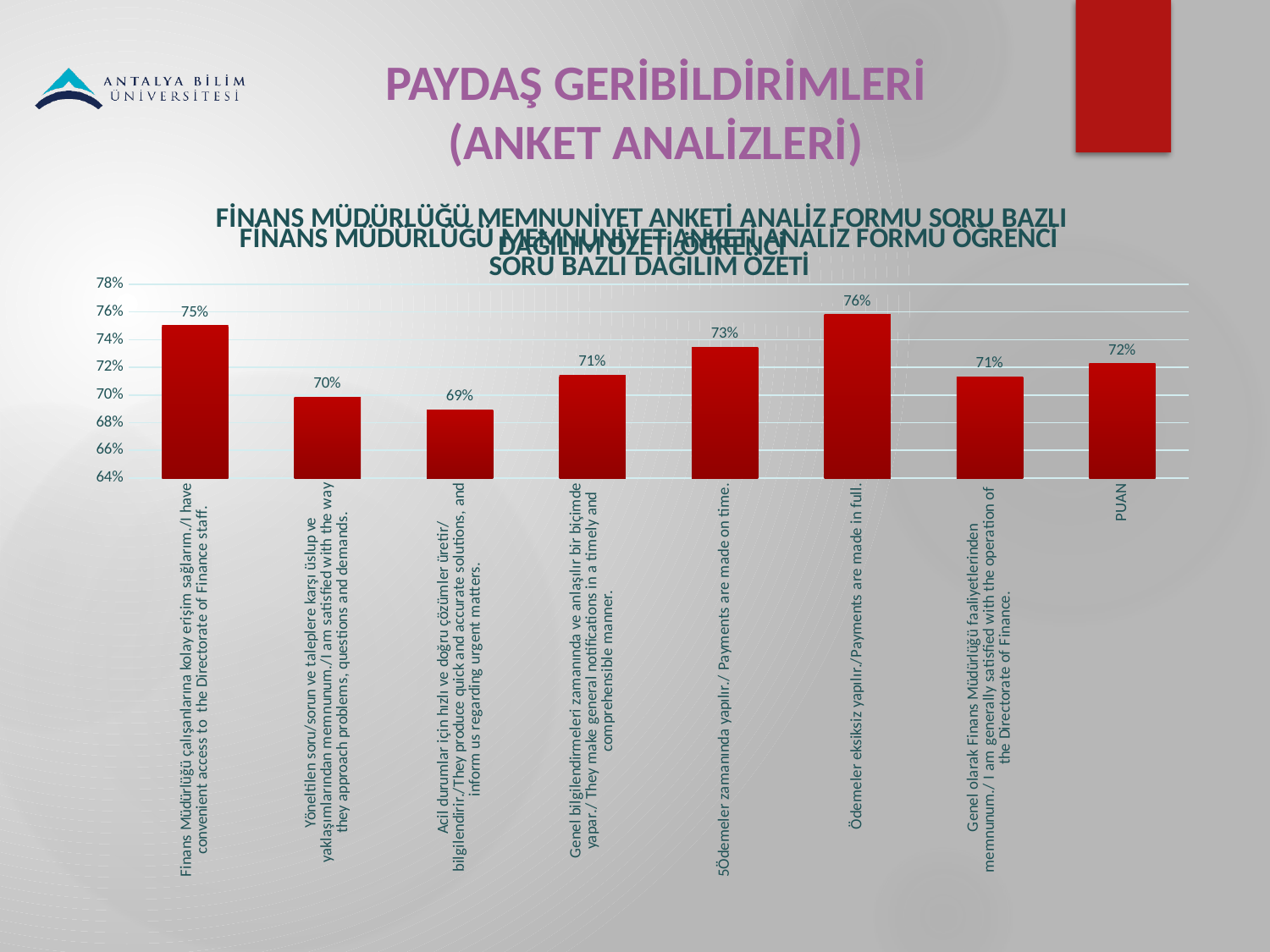
What colour are the bars in the chart? red What is the value for the category "Ödemeler eksiksiz yapılır./Payments are made in full."? 76% What is the value for the category "Ödemeler zamanında yapılır./ Payments are made on time."? 73% Which is larger: the value for "Ödemeler zamanında yapılır./ Payments are made on time." or the value for "PUAN"? Ödemeler zamanında yapılır./ Payments are made on time. What is the difference between the highest value (76%) and the lowest value (69%)? 7% How many bars are plotted in the chart? 8 What is the value for the first bar, "Finans Müdürlüğü çalışanlarına kolay erişim sağlarım./I have convenient access to the Directorate of Finance staff."? 75% Which category has the highest value? Ödemeler eksiksiz yapılır./Payments are made in full. What is the value for "Yöneltilen soru/sorun ve taleplere karşı üslup ve yaklaşımlarından memnunum./I am satisfied with the way they approach problems, questions and demands."? 70% What is the value of the bar labelled "PUAN"? 72% Which category has the lowest value? Acil durumlar için hızlı ve doğru çözümler üretir/bilgilendirir./They produce quick and accurate solutions, and inform us regarding urgent matters. What kind of chart is shown on the slide? bar chart